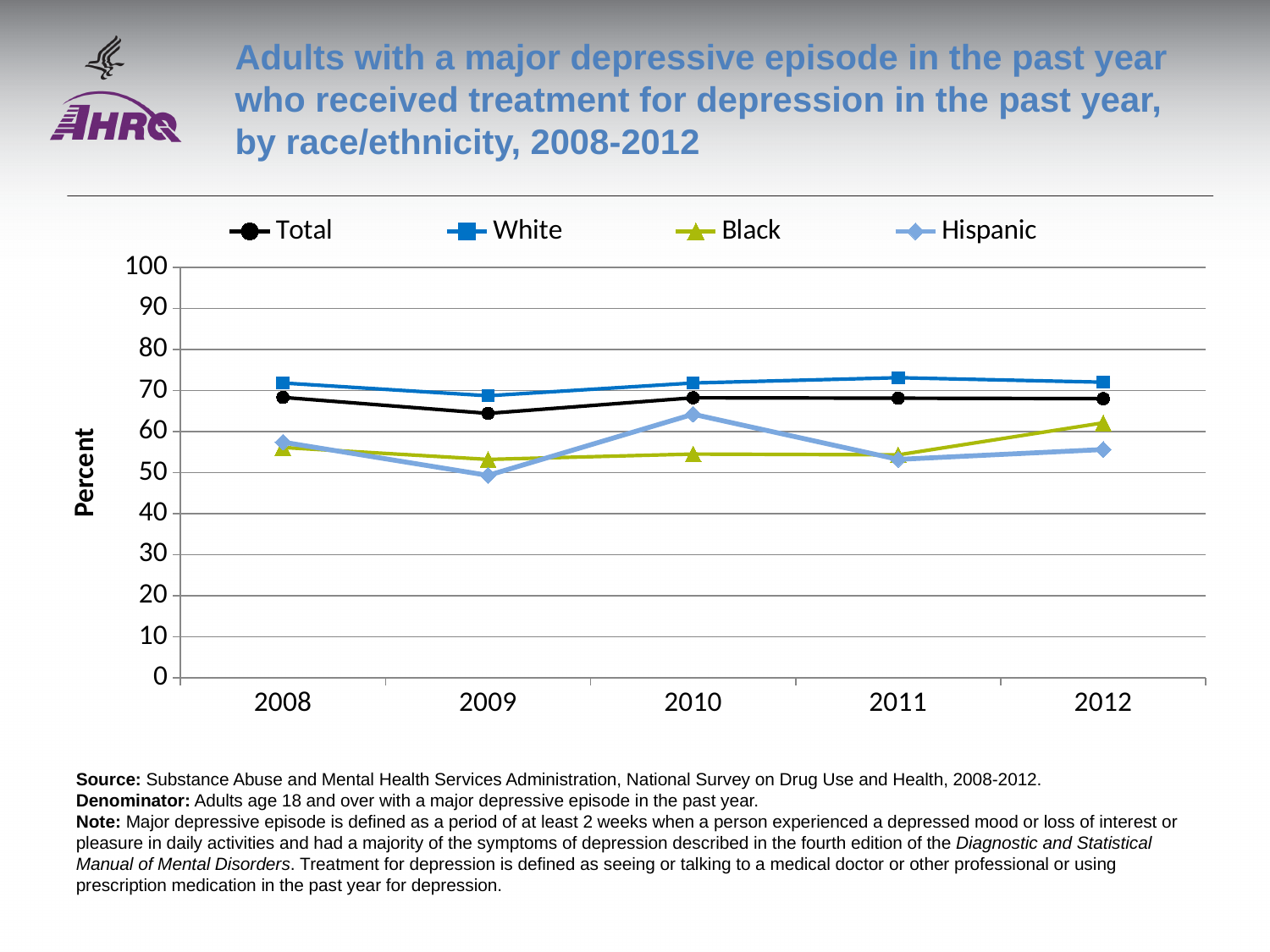
How many years are shown on the x axis? 5 Is the value for Total in 2009 greater or less than 70? less Is the value for Hispanic in 2009 greater or less than 60? less Which series has the highest value in 2011? White How many series does the legend list? 4 Which series has the lowest value in 2009? Hispanic Is the value for White in 2011 greater or less than 70? greater Does the Hispanic line rise or fall from 2009 to 2010? rise In 2010, which is larger, the value for White or the value for Black? White What kind of chart is shown on the slide? line chart What is the label on the y axis? Percent